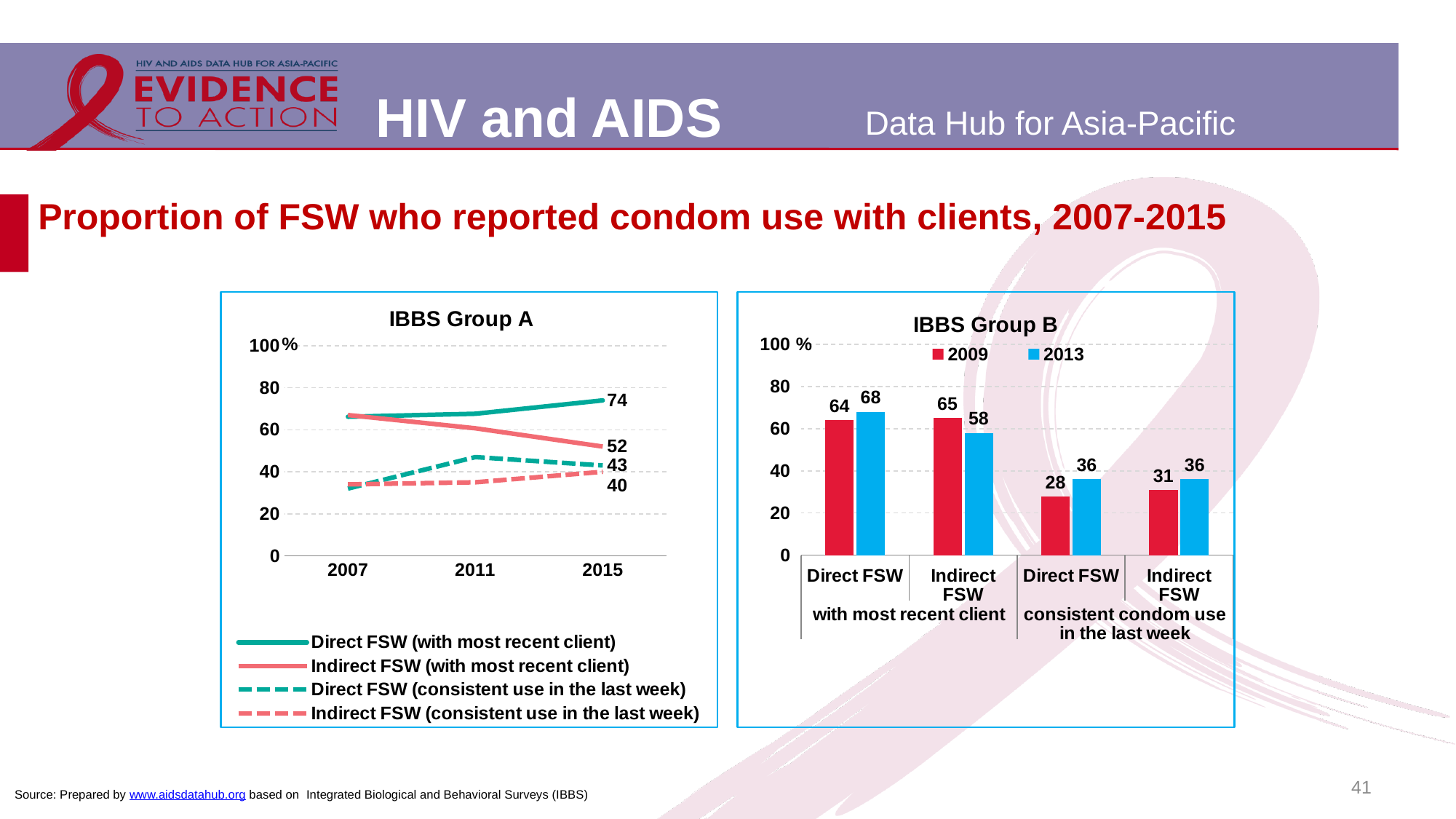
In the IBBS Group A chart, how many series does the legend list? 4 In the IBBS Group A chart, what is the value for Indirect FSW (consistent use in the last week) in 2015? 40 In the IBBS Group A chart, what is the value for Direct FSW (with most recent client) in 2015? 74 In the IBBS Group A chart, does the Indirect FSW (with most recent client) line rise or fall from 2007 to 2015? Fall In the IBBS Group B chart, which category has the highest 2013 value? Direct FSW with most recent client In the IBBS Group B chart, what is the difference between the 2009 and 2013 values for Indirect FSW with most recent client? 7 In the IBBS Group B chart, what kind of chart is shown? Bar chart In the IBBS Group B chart, which is larger for Indirect FSW consistent condom use in the last week: the 2009 value or the 2013 value? 2013 In the IBBS Group A chart, is the value for Direct FSW (with most recent client) in 2007 greater or less than 40? greater In the IBBS Group A chart, what kind of chart is shown? Line chart In the IBBS Group B chart, what is the 2013 value for Direct FSW with most recent client? 68 In the IBBS Group B chart, what is the 2009 value for Direct FSW consistent condom use in the last week? 28